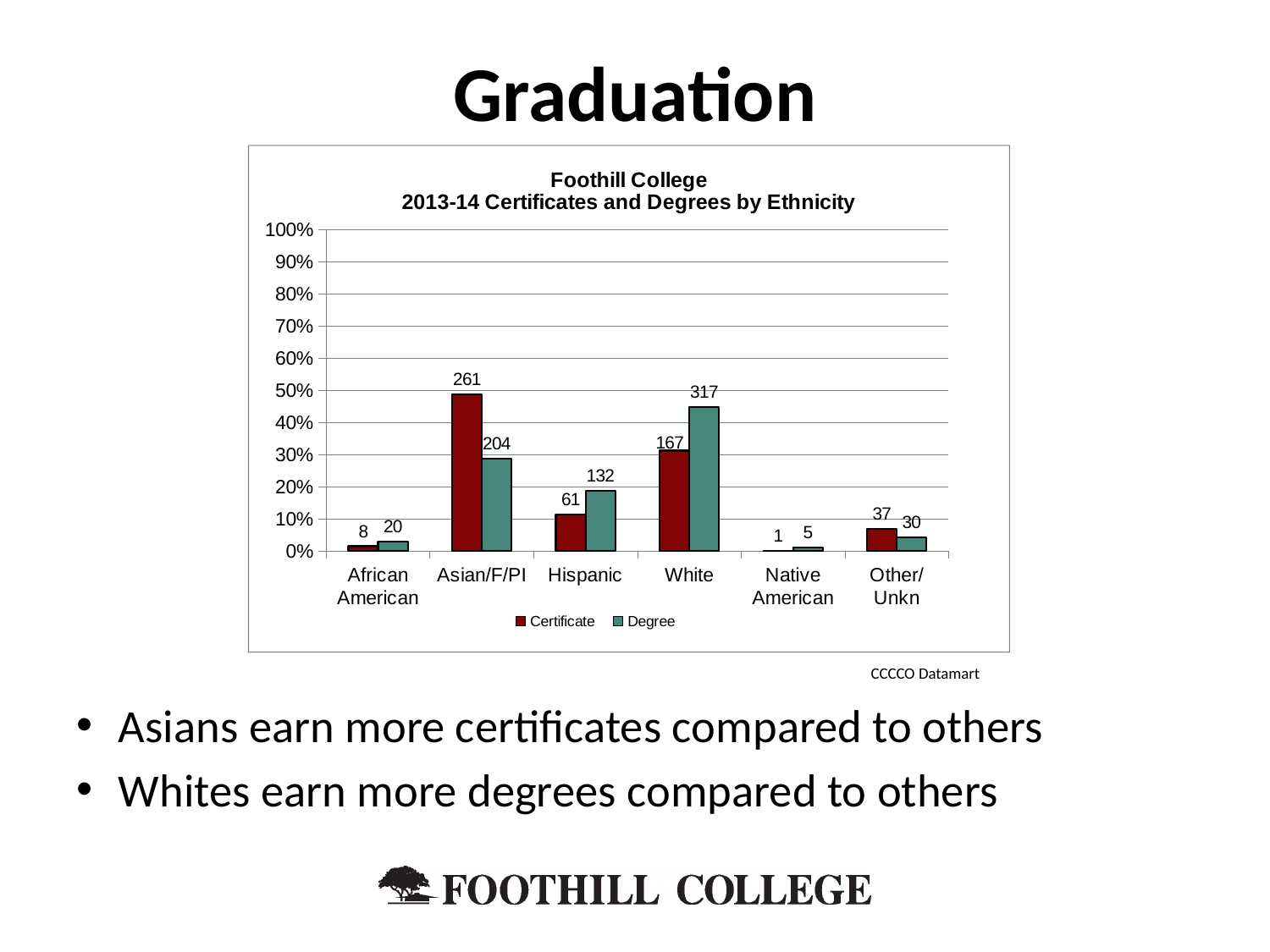
Which ethnicity has the highest Certificate value? Asian/F/PI How many series does the legend list? 2 What type of chart is shown on the slide? Bar chart What is the difference between the Degree and Certificate labels for White? 150 Which is larger for Other/Unkn, the Certificate value or the Degree value? Certificate Which ethnicity has the lowest Degree value? Native American What is the data label on the Certificate bar for Asian/F/PI? 261 What is the data label on the Degree bar for Hispanic? 132 How many ethnicity categories are shown on the x axis? 6 Is the Degree bar for White greater or less than 40% on the axis? greater What is the data label on the Degree bar for White? 317 What is the data label on the Certificate bar for Native American? 1